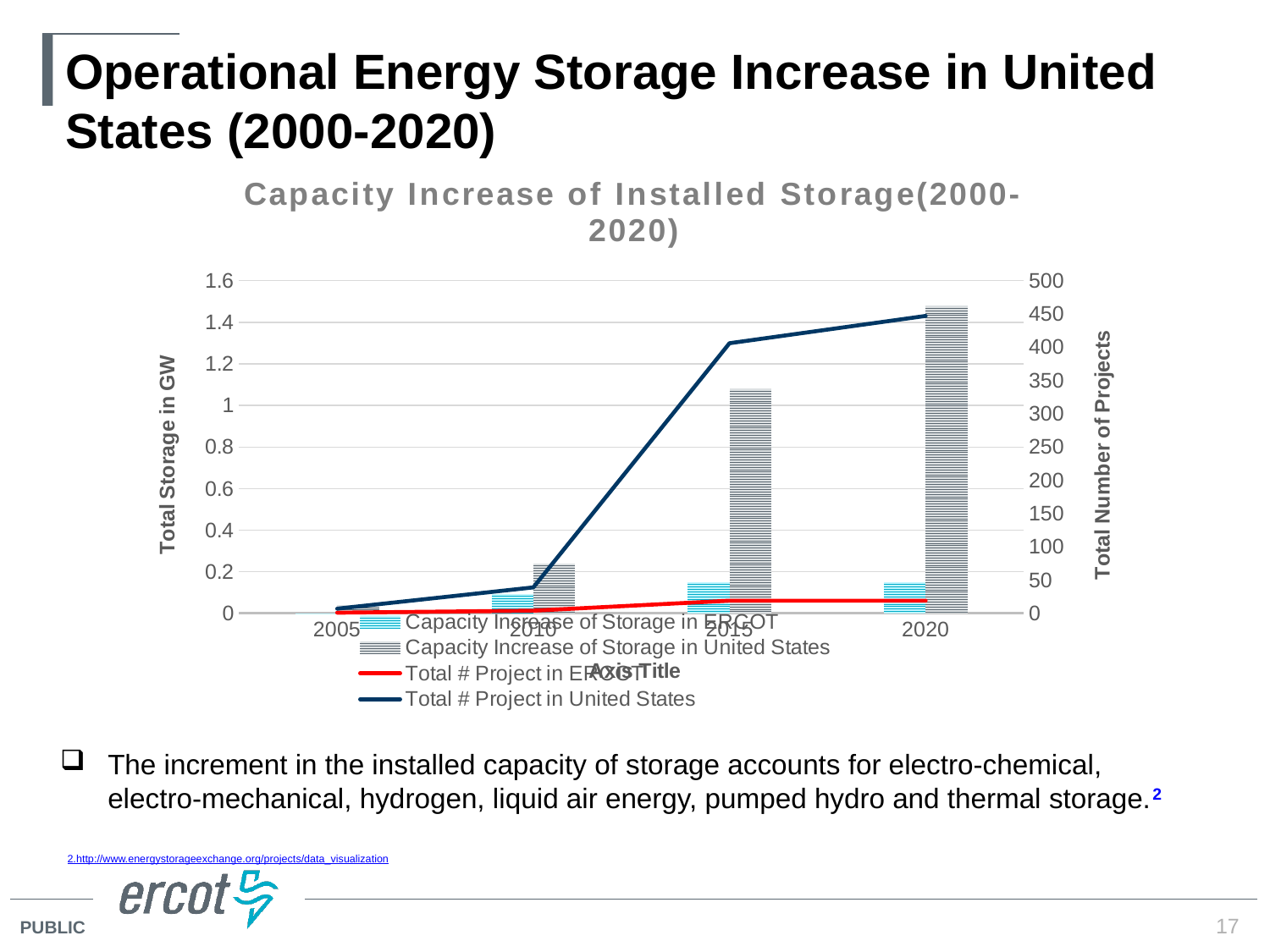
Does the Total # Project in United States line rise or fall from 2005 to 2020? Rise How many years are shown on the x axis? 4 Is the Total # Project in ERCOT for 2020 greater or less than 50? less In which year is the Capacity Increase of Storage in United States bar the highest? 2020 Is the Capacity Increase of Storage in United States for 2020 greater or less than 1.2 GW? greater In 2020, which is larger: the Capacity Increase of Storage in ERCOT or the Capacity Increase of Storage in United States? Capacity Increase of Storage in United States What is the title of the left vertical axis? Total Storage in GW What kind of chart is shown on the slide? A combined bar and line chart In which year is the Capacity Increase of Storage in United States bar the lowest? 2005 Is the Capacity Increase of Storage in United States for 2010 greater or less than 0.4 GW? less How many series does the legend list? 4